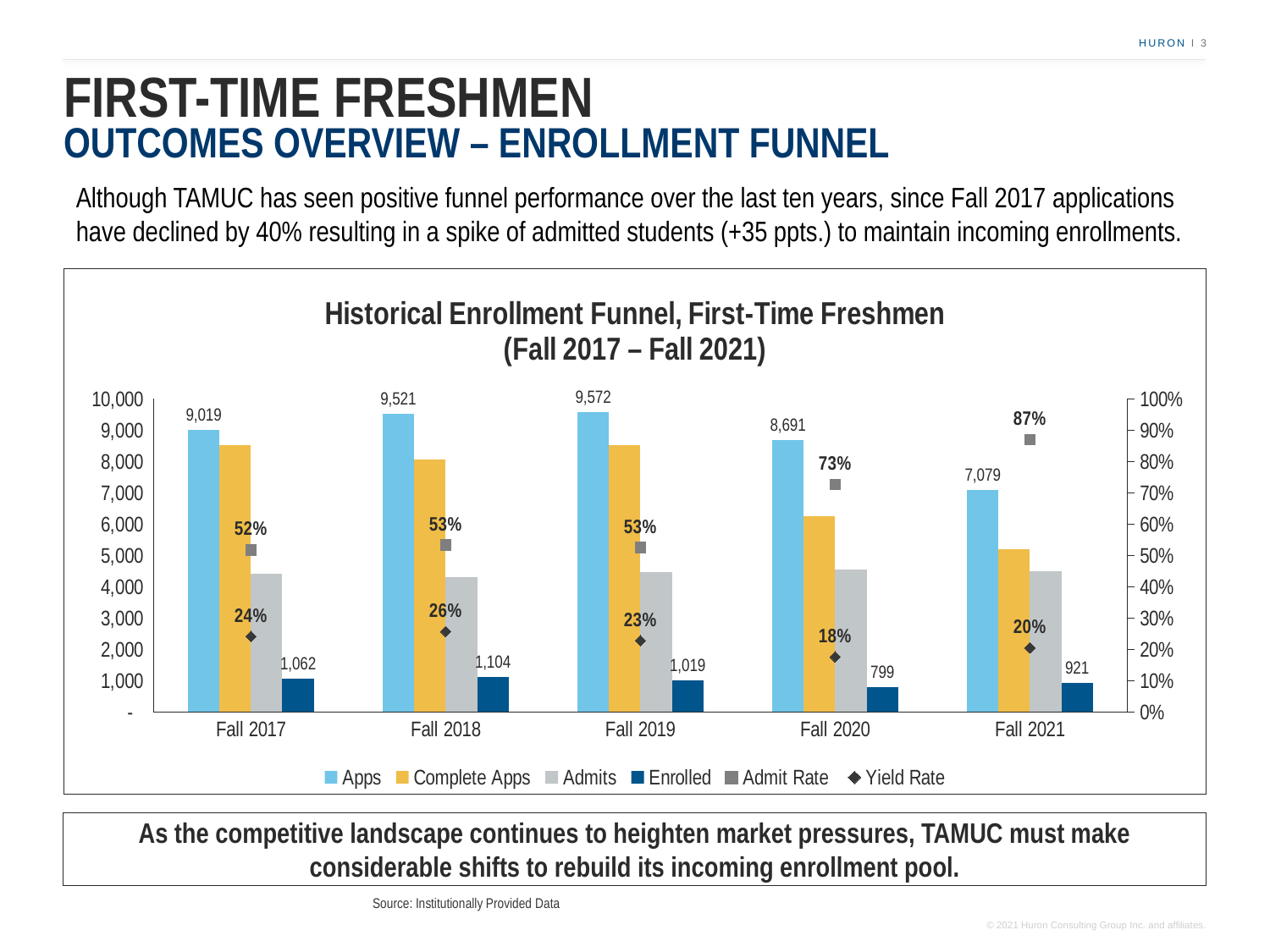
What is the value of Apps for Fall 2019? 9,572 How many series does the legend list? 6 What is the Admit Rate for Fall 2021? 87% What is the Yield Rate for Fall 2018? 26% Does the Admit Rate rise or fall from Fall 2019 to Fall 2021? rise Which year has the lowest Enrolled value? Fall 2020 Which is larger, the Enrolled value for Fall 2018 or for Fall 2021? Fall 2018 What is the difference in Apps between Fall 2017 and Fall 2021? 1,940 Is the Complete Apps value for Fall 2020 greater or less than 7,000? less What is the Enrolled value for Fall 2020? 799 Which year has the highest Apps value? Fall 2019 How many years are shown on the x axis? 5